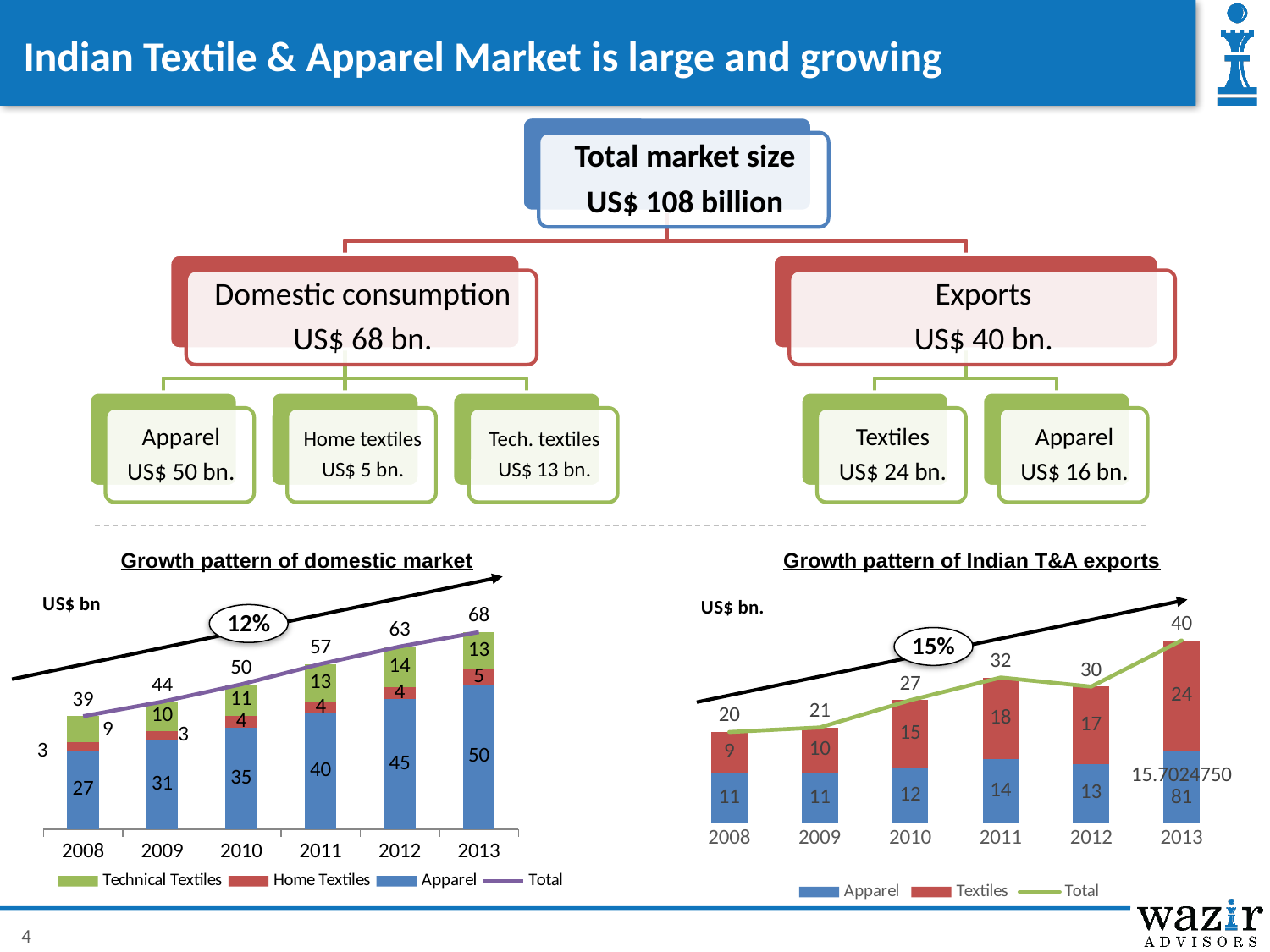
In the 'Growth pattern of Indian T&A exports' chart, what is the Total value for 2010? 27 In the 'Growth pattern of Indian T&A exports' chart, which is larger in 2012, Apparel or Textiles? Textiles In the 'Growth pattern of domestic market' chart, what is the Apparel value for 2011? 40 In the 'Growth pattern of domestic market' chart, what is the Total value for 2013? 68 In the 'Growth pattern of Indian T&A exports' chart, how many years are shown on the x axis? 6 In the 'Growth pattern of Indian T&A exports' chart, which year has the highest Total value? 2013 In the 'Growth pattern of domestic market' chart, what is the Technical Textiles value for 2012? 14 In the 'Growth pattern of domestic market' chart, which year has the lowest Total value? 2008 In the 'Growth pattern of domestic market' chart, does the Total rise or fall from 2008 to 2013? rise In the 'Growth pattern of Indian T&A exports' chart, what is the Textiles value for 2011? 18 In the 'Growth pattern of domestic market' chart, how many series does the legend list? 4 In the 'Growth pattern of domestic market' chart, what is the difference between the Apparel values for 2013 and 2008? 23